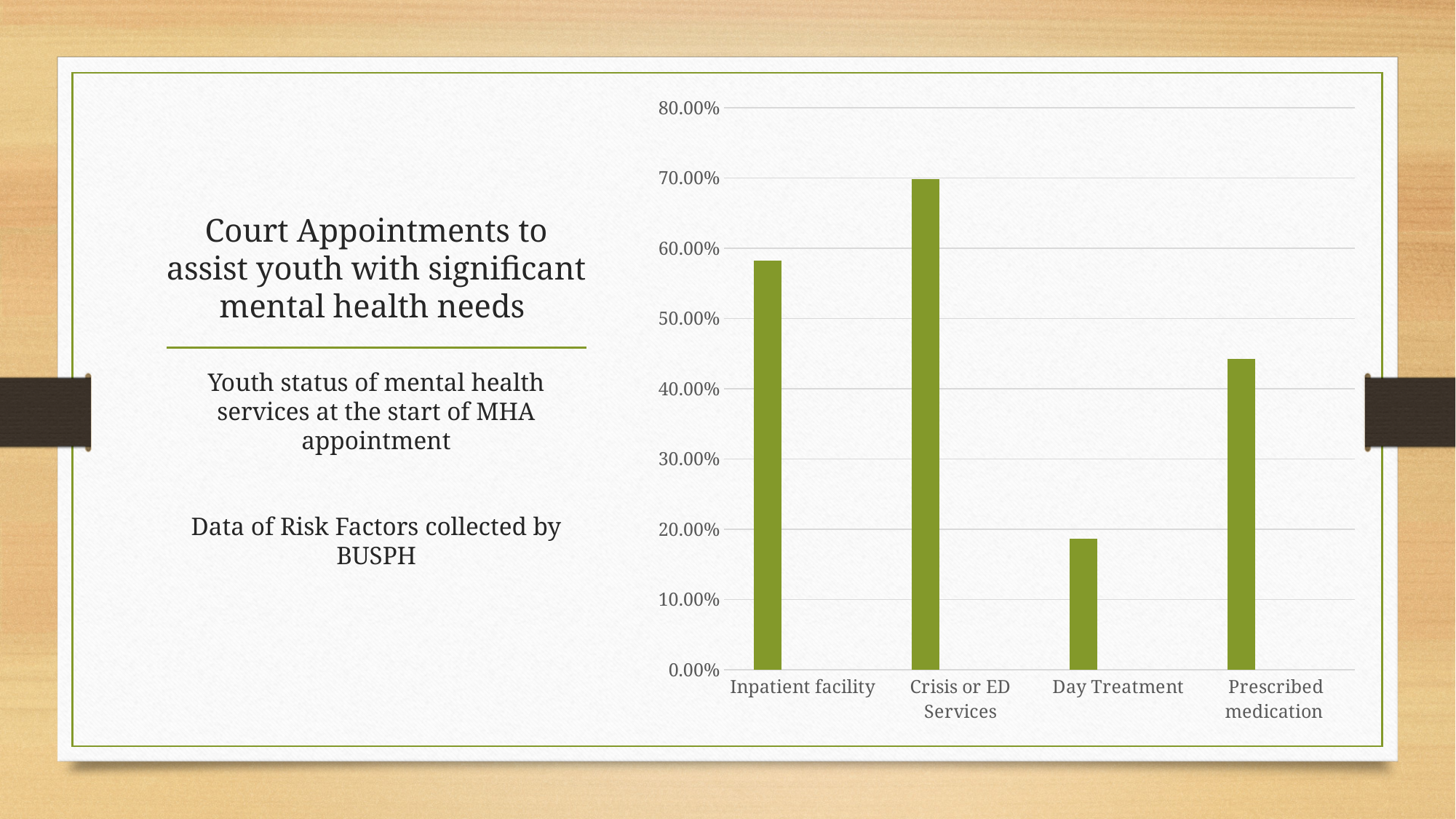
Is the value for Inpatient facility greater or less than 60.00%? less Which is larger, the value for Day Treatment or the value for Prescribed medication? Prescribed medication Is the value for Crisis or ED Services greater or less than 60.00%? greater How many categories are shown on the x axis of the chart? 4 Is the value for Inpatient facility greater or less than 50.00%? greater Which is larger, the value for Inpatient facility or the value for Prescribed medication? Inpatient facility Which category has the lowest bar in the chart? Day Treatment What kind of chart is shown on the slide? bar chart What is the highest value shown on the chart's y axis? 80.00% Which category has the highest bar in the chart? Crisis or ED Services